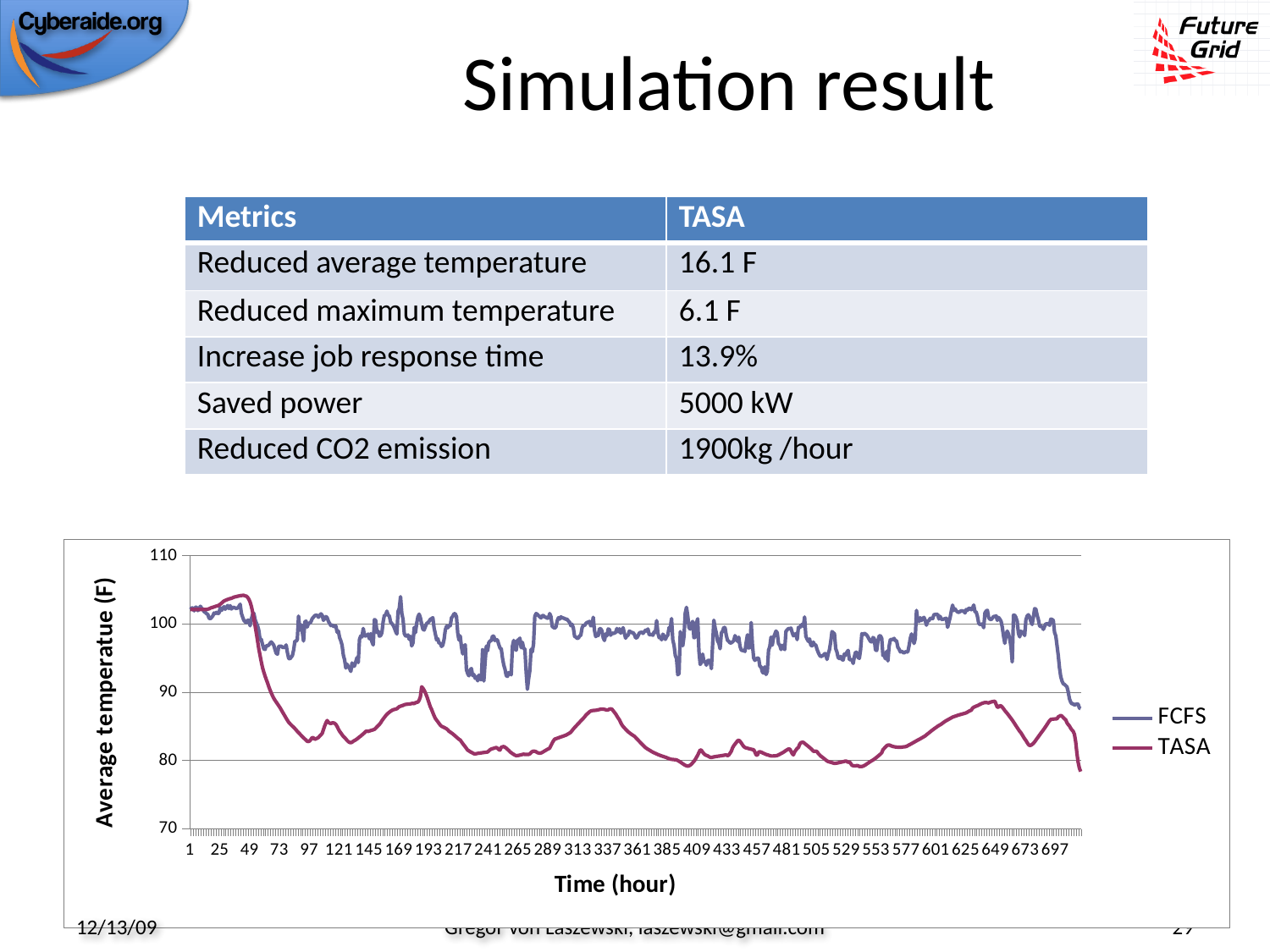
What is the highest value shown on the chart's y axis? 110 Is the value for FCFS at hour 601 greater or less than 90? greater Which series generally has the higher average temperature across the chart, FCFS or TASA? FCFS Is the value for FCFS at hour 169 greater or less than 90? greater Is the value for TASA at hour 1 greater or less than 100? greater What are the two series named in the chart's legend? FCFS and TASA What is the title of the chart's x axis? Time (hour) Does the TASA series rise or fall between hour 49 and hour 97? fall What kind of chart is shown on the slide? line chart How many series does the chart's legend list? 2